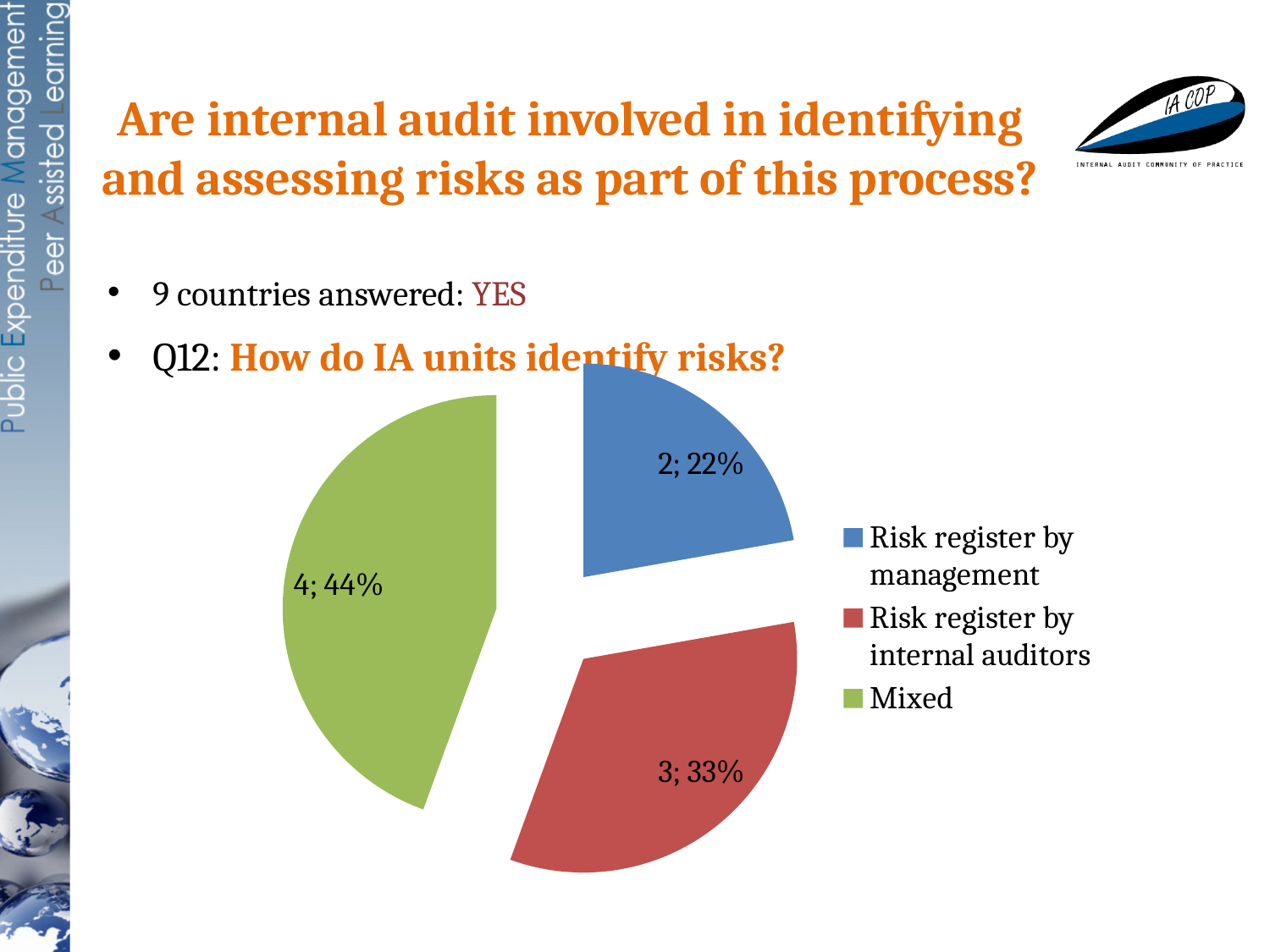
How many slices does the pie chart have? 3 What is the count shown for the 'Mixed' slice? 4 Which is larger: the 'Risk register by internal auditors' slice or the 'Risk register by management' slice? Risk register by internal auditors What colour is the 'Mixed' slice in the pie chart? green Which category has the largest slice of the pie? Mixed How many entries does the legend of the pie chart list? 3 What share of the pie does the 'Mixed' slice represent? 44% What kind of chart is shown on the slide? pie chart Which category has the smallest slice of the pie? Risk register by management What percentage is shown for the 'Risk register by internal auditors' slice? 33% What is the difference in count between the 'Mixed' slice and the 'Risk register by management' slice? 2 What percentage is shown for the 'Risk register by management' slice? 22%